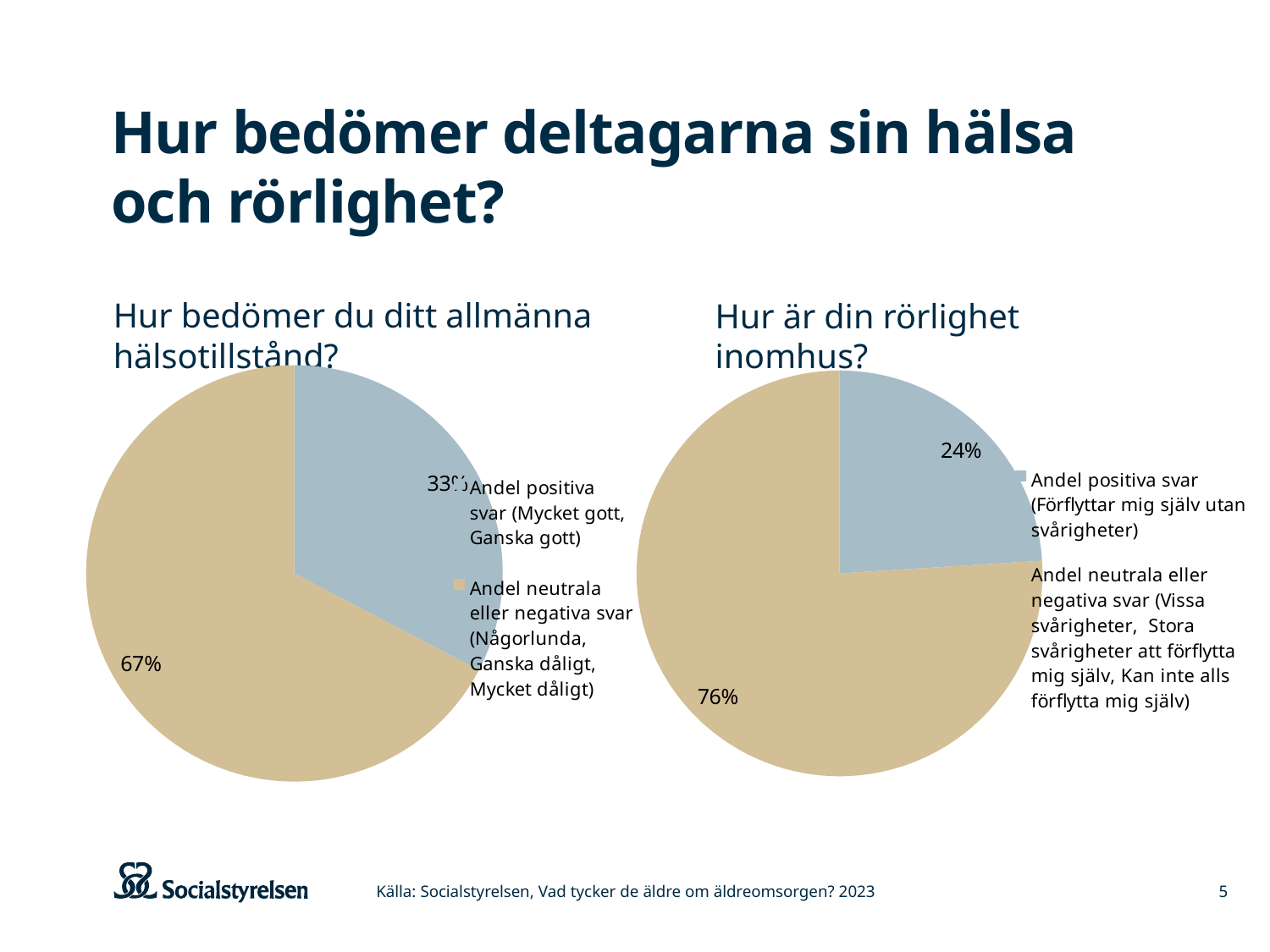
In the chart titled "Hur är din rörlighet inomhus?", what share is labelled for the neutral or negative answers (Andel neutrala eller negativa svar)? 76% In the chart titled "Hur bedömer du ditt allmänna hälsotillstånd?", what is the difference in percentage points between the neutral/negative share and the positive share? 34 In the chart titled "Hur är din rörlighet inomhus?", which slice is the largest? Andel neutrala eller negativa svar What type of chart is used on the left side of the slide, titled "Hur bedömer du ditt allmänna hälsotillstånd?"? Pie chart Which chart shows a larger share of positive answers, the left one (allmänna hälsotillstånd) or the right one (rörlighet inomhus)? The left one (allmänna hälsotillstånd) In the chart titled "Hur är din rörlighet inomhus?", what colour is the slice for positive answers (Andel positiva svar)? Blue In the chart titled "Hur är din rörlighet inomhus?", what is the difference in percentage points between the neutral/negative share and the positive share? 52 In the chart titled "Hur bedömer du ditt allmänna hälsotillstånd?", what share is labelled for the neutral or negative answers (Andel neutrala eller negativa svar)? 67% How many slices does the chart titled "Hur är din rörlighet inomhus?" have? 2 In the chart titled "Hur är din rörlighet inomhus?", what share is labelled for the positive answers (Andel positiva svar)? 24% In the chart titled "Hur bedömer du ditt allmänna hälsotillstånd?", which slice is the smallest? Andel positiva svar In the chart titled "Hur bedömer du ditt allmänna hälsotillstånd?", what share is labelled for the positive answers (Andel positiva svar)? 33%